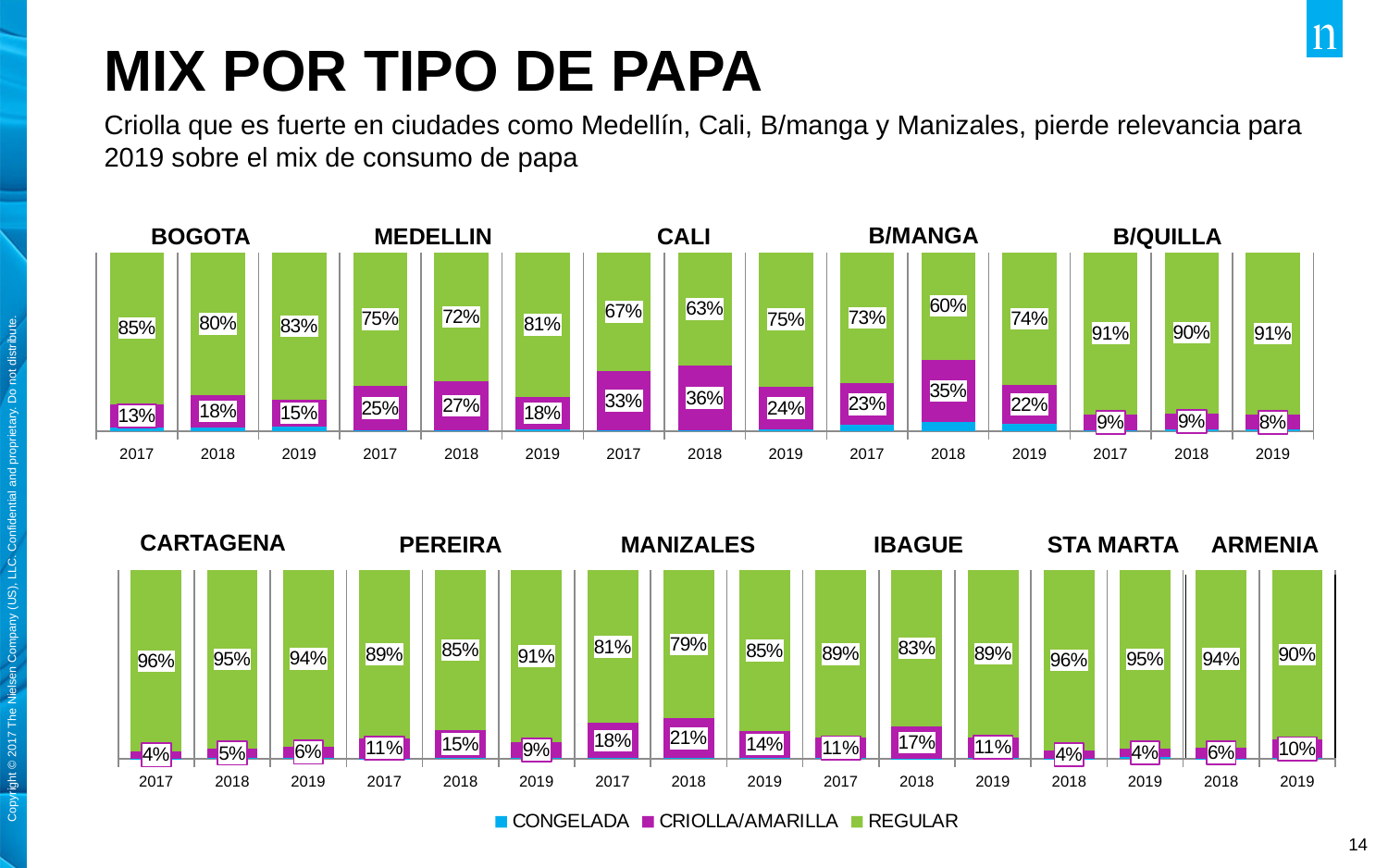
How many series does the legend list? 3 In the CALI chart, what is the difference between the REGULAR share in 2019 and in 2018? 12 percentage points In the PEREIRA chart, is the CRIOLLA/AMARILLA share larger in 2018 or in 2019? 2018 Which series is shown in green in the legend? REGULAR In the B/MANGA chart, what is the CRIOLLA/AMARILLA share in 2018? 35% In the MANIZALES chart, which year has the lowest CRIOLLA/AMARILLA share? 2019 In the CARTAGENA chart, does the CRIOLLA/AMARILLA share rise or fall from 2017 to 2019? Rise What kind of chart is used for each city on the slide? Stacked bar chart In the CALI chart, what is the REGULAR share in 2018? 63% In the MEDELLIN chart, what is the CRIOLLA/AMARILLA share in 2019? 18% How many years are shown in the STA MARTA chart? 2 In the BOGOTA chart, which year has the highest REGULAR share? 2017